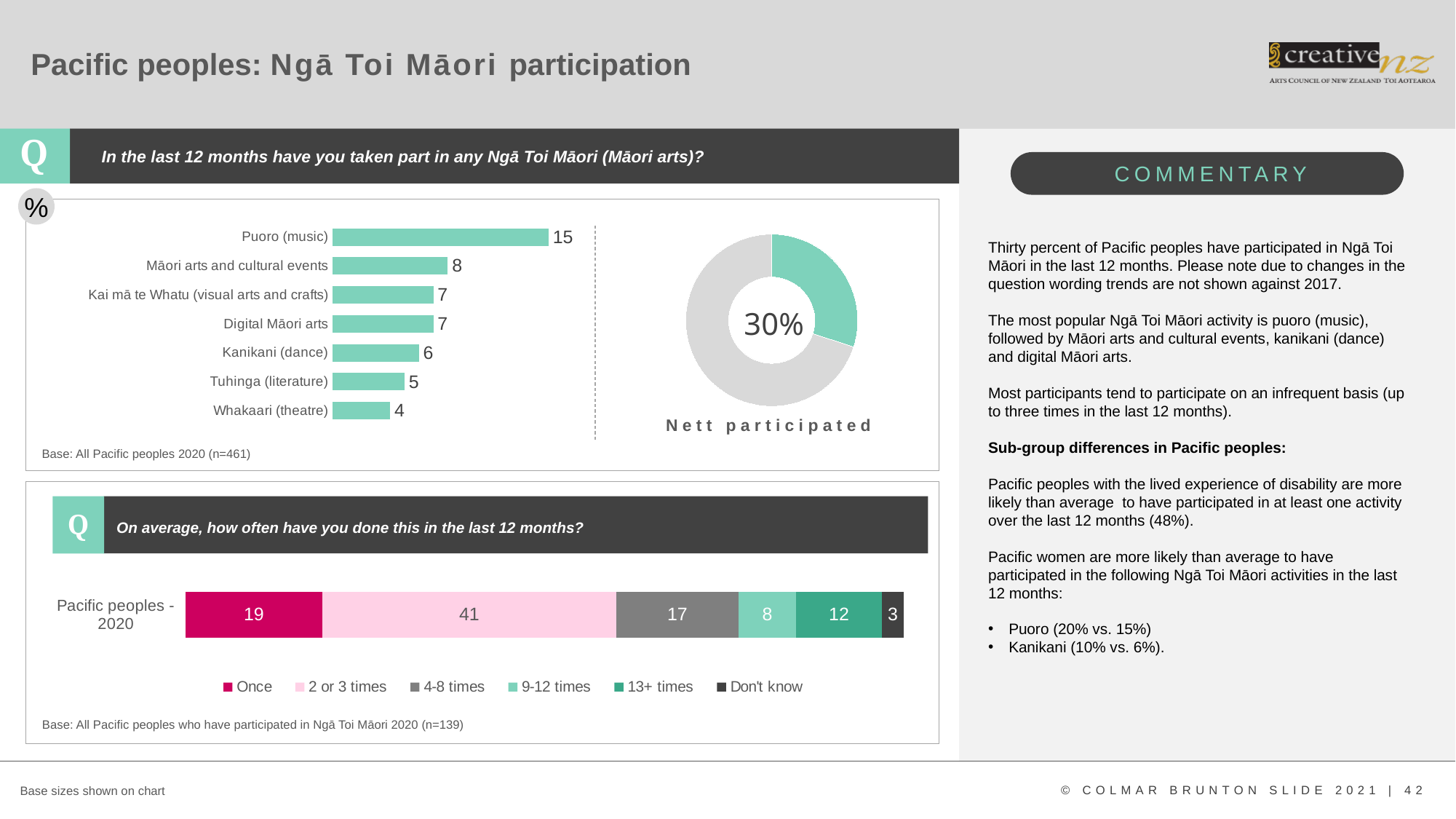
In the bar chart of Ngā Toi Māori activities, what is the value for Puoro (music)? 15 In the bar chart of Ngā Toi Māori activities, what is the difference between Puoro (music) and Māori arts and cultural events? 7 In the bar chart of Ngā Toi Māori activities, which is larger: Kanikani (dance) or Tuhinga (literature)? Kanikani (dance) In the stacked bar chart on how often Pacific peoples participated, what is the value for 2 or 3 times? 41 How many activities are listed in the bar chart of Ngā Toi Māori activities? 7 How many series does the legend of the stacked bar chart on frequency of participation list? 6 What kind of chart is the Nett participated chart? Donut chart In the bar chart of Ngā Toi Māori activities, which activity has the highest value? Puoro (music) In the bar chart of Ngā Toi Māori activities, which activity has the lowest value? Whakaari (theatre) In the stacked bar chart on how often Pacific peoples participated, what is the value for 13+ times? 12 In the stacked bar chart on frequency of participation, what is the total of the Pacific peoples - 2020 bar? 100 In the donut chart labelled Nett participated, what percentage is shown in the centre? 30%